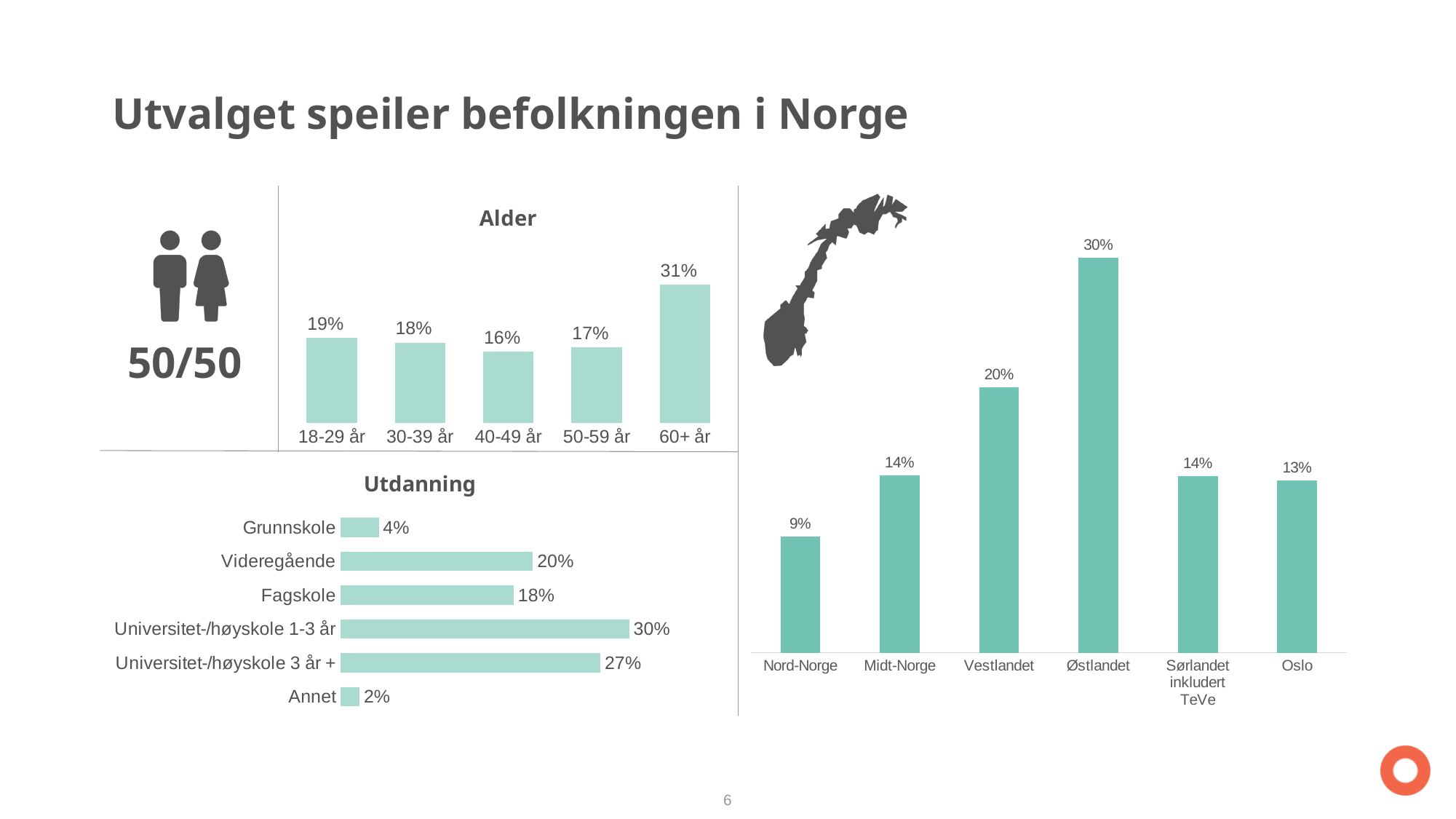
In the Alder chart, which age group has the lowest value? 40-49 år In the Utdanning chart, which category has the lowest value? Annet In the regional chart on the right, what is the value for Vestlandet? 20% In the Utdanning chart, what is the value for Fagskole? 18% In the Utdanning chart, how many categories are shown? 6 In the regional chart on the right, what is the difference between Østlandet and Nord-Norge? 21% In the Alder chart, how many age groups are shown? 5 In the Alder chart, what is the difference between 18-29 år and 40-49 år? 3% In the Utdanning chart, which is larger: Videregående or Fagskole? Videregående In the Utdanning chart, which category has the highest value? Universitet-/høyskole 1-3 år In the regional chart on the right, which region has the highest value? Østlandet In the Alder chart, what is the value for 60+ år? 31%